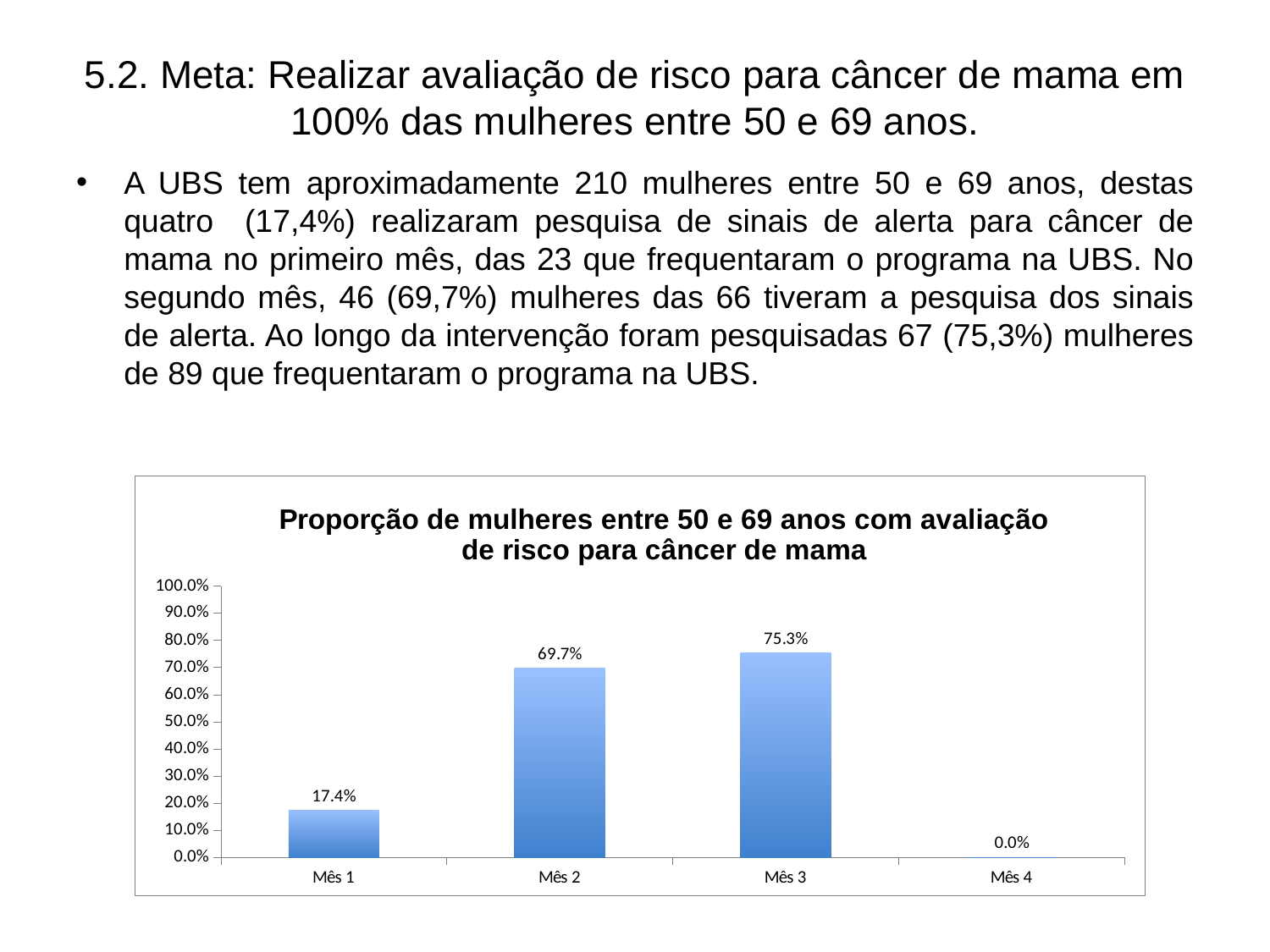
How many months are shown on the x axis? 4 Which is larger, the value for Mês 1 or the value for Mês 2? Mês 2 What is the title of the chart? Proporção de mulheres entre 50 e 69 anos com avaliação de risco para câncer de mama Which month has the highest value? Mês 3 What is the value for Mês 2? 69.7% What is the difference between the values for Mês 2 and Mês 1? 52.3% Which month has the lowest value? Mês 4 What kind of chart is shown on the slide? Bar chart What is the value for Mês 1? 17.4% What is the difference between the values for Mês 3 and Mês 2? 5.6% What is the value for Mês 3? 75.3% What is the value for Mês 4? 0.0%